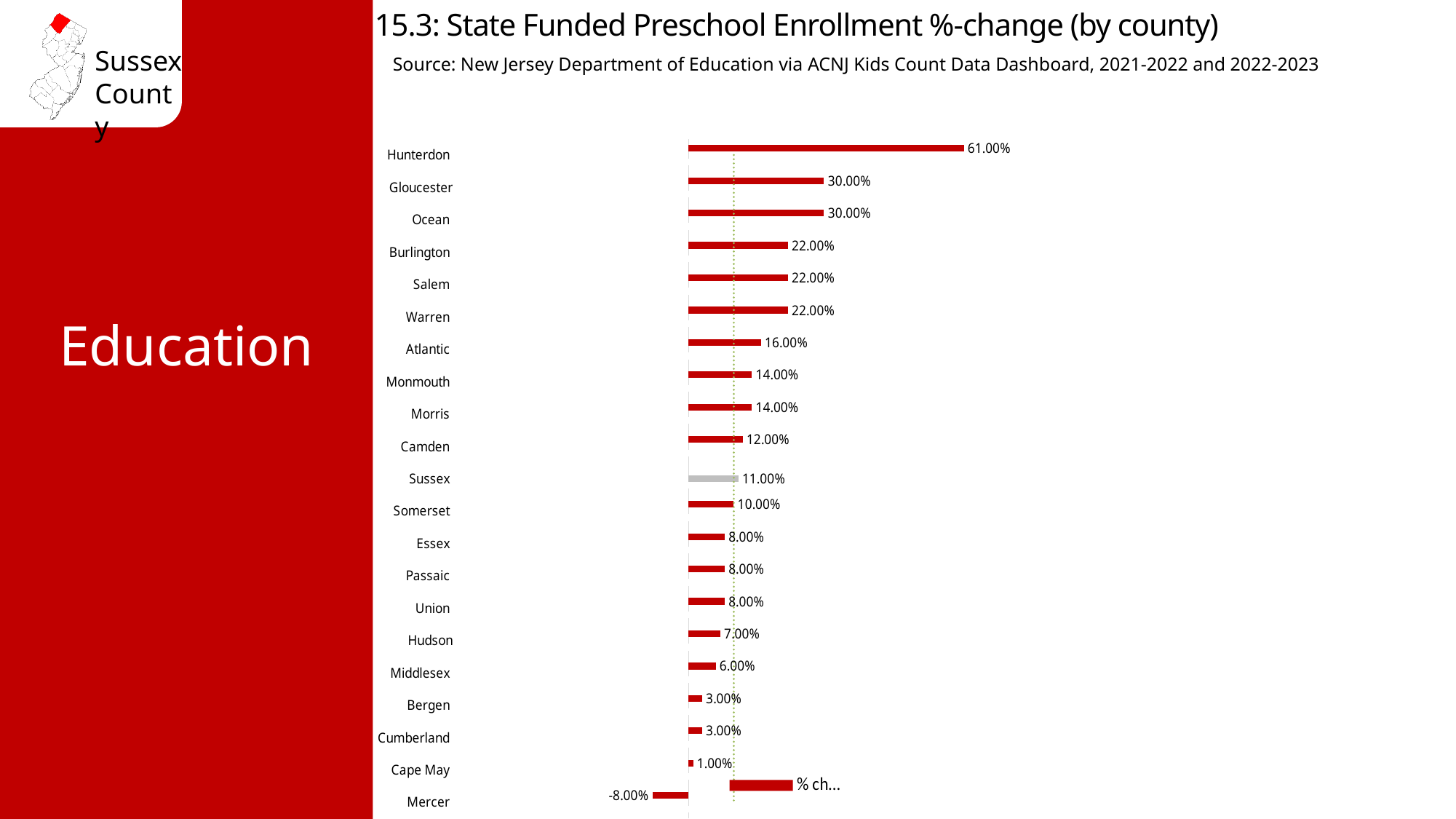
How many counties are shown in the chart? 21 What is the difference between the %-change for Hunterdon and the %-change for Gloucester? 31.00% Which county's bar is drawn in gray rather than red? Sussex What kind of chart is shown on the slide? Bar chart What is the difference between the %-change for Sussex and the %-change for Cape May? 10.00% Which county has the lowest state funded preschool enrollment %-change? Mercer What is the state funded preschool enrollment %-change for Hunterdon? 61.00% What is the %-change value shown for Mercer? -8.00% Which has a larger %-change, Middlesex or Somerset? Somerset Which has a larger %-change, Atlantic or Camden? Atlantic What is the %-change value shown for Sussex? 11.00% Which county has the highest state funded preschool enrollment %-change? Hunterdon